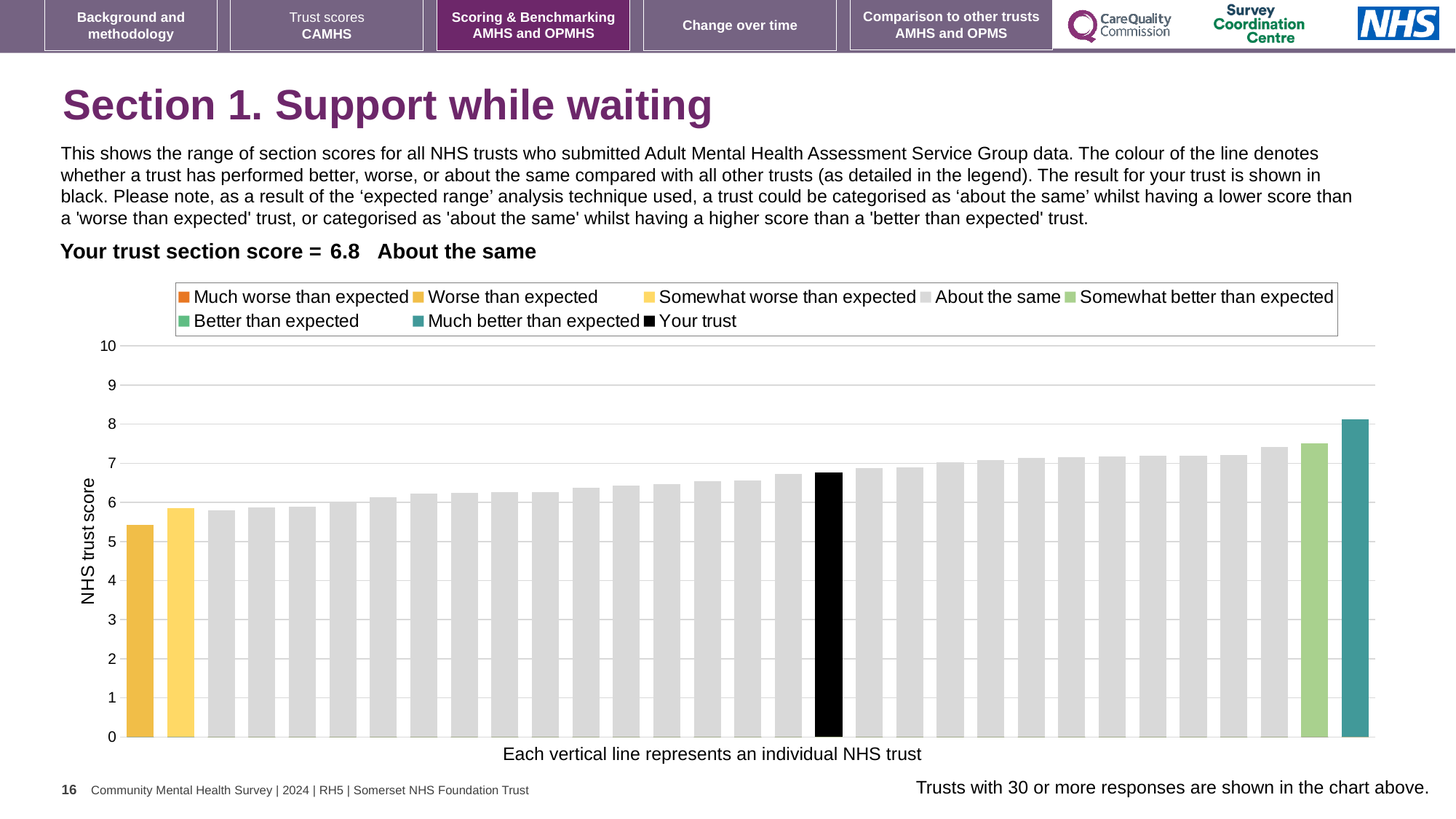
Do the bar values rise or fall from left to right along the x axis? Rise Is the value for the leftmost bar greater or less than 6? less How many entries does the chart legend list? 8 What colour is used for the 'Your trust' bar in the chart? Black Is the value for the rightmost (teal) bar greater or less than 7? greater Which legend category does the highest bar in the chart belong to? Much better than expected Is the value for the black 'Your trust' bar greater or less than 7? less What is the section score for your trust shown on the slide? 6.8 What is the label on the vertical axis of the chart? NHS trust score What kind of chart is shown on the slide? Bar chart Which is larger: the value for the black 'Your trust' bar or the value for the leftmost bar? Your trust